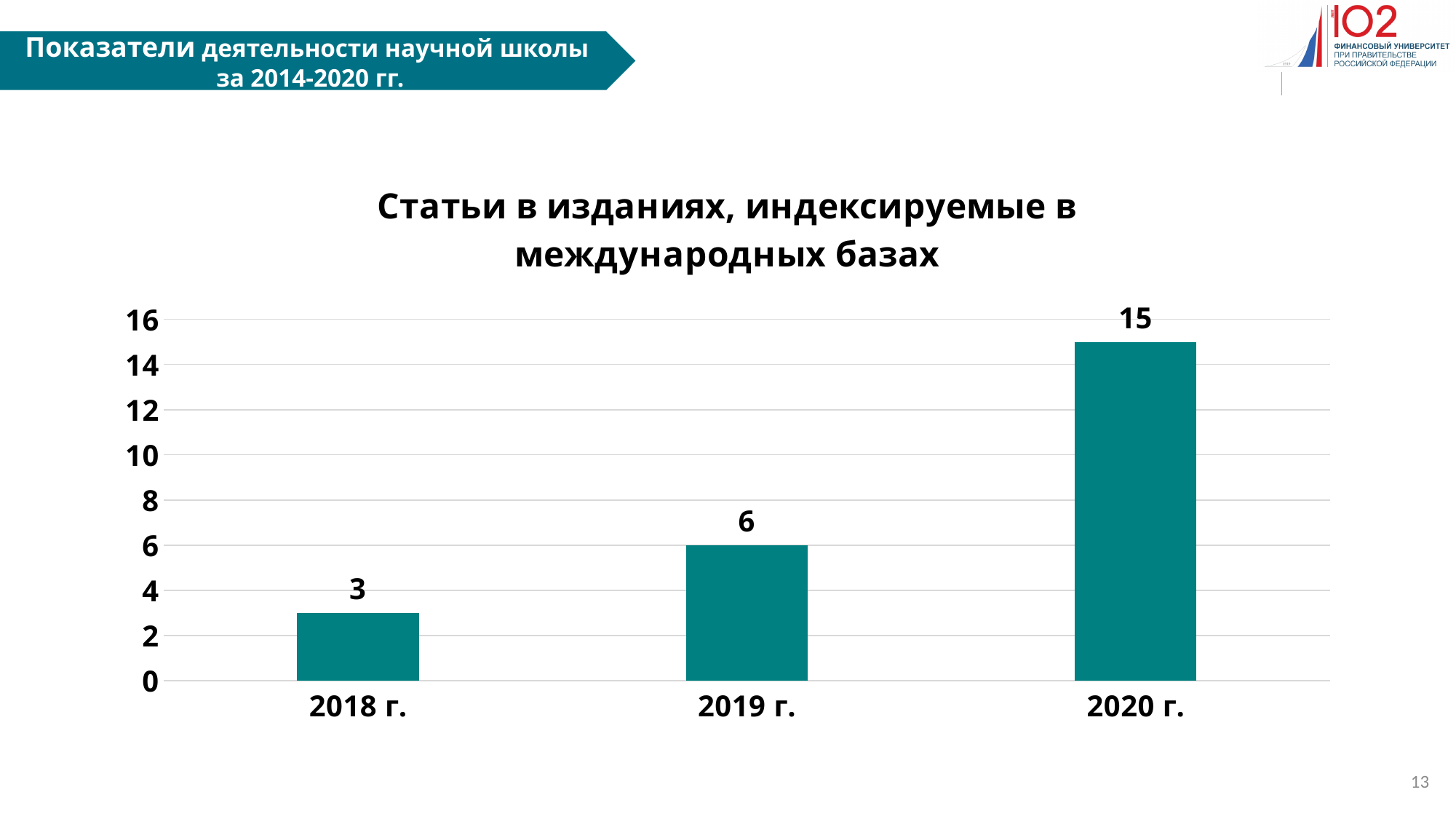
Which year has the lowest value? 2018 г. What kind of chart is shown on the slide? bar chart What is the value for 2020 г.? 15 Is the value for 2020 г. greater or less than 10? greater Which year has the highest value? 2020 г. What is the difference between the values for 2019 г. and 2018 г.? 3 What is the value for 2018 г.? 3 What is the value for 2019 г.? 6 What is the difference between the values for 2020 г. and 2019 г.? 9 Which is larger, the value for 2018 г. or the value for 2019 г.? 2019 г. Do the values rise or fall from 2018 г. to 2020 г.? rise How many years are shown on the chart? 3